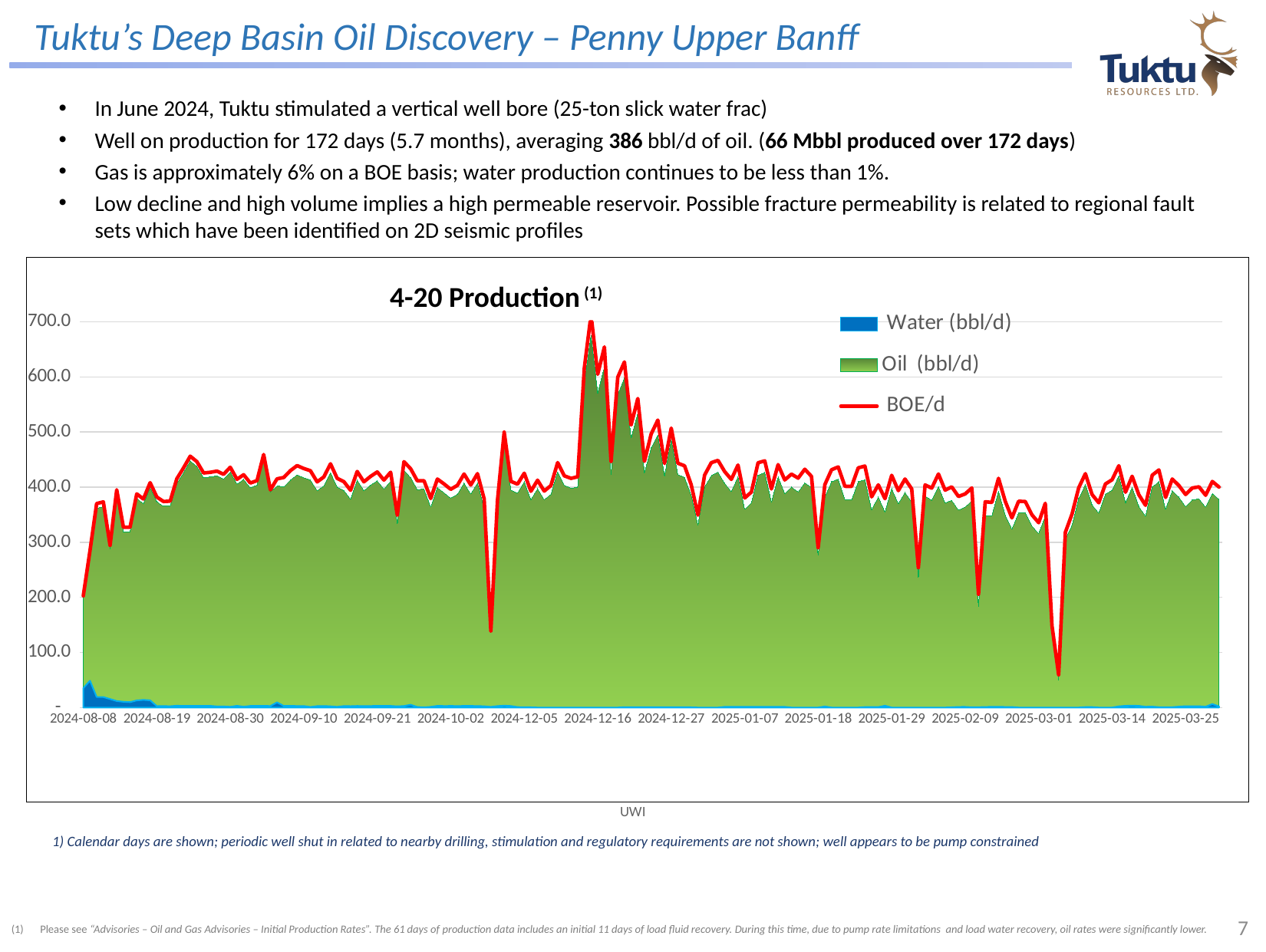
Is the BOE/d value at the start of the chart (2024-08-08) greater or less than 300? less What are the three series listed in the legend of the 4-20 Production chart? Water (bbl/d), Oil (bbl/d), BOE/d How many series does the legend of the 4-20 Production chart list? 3 What is the highest value shown on the y axis of the 4-20 Production chart? 700.0 Is the Water (bbl/d) value at any point in the chart greater or less than 100? less Which series in the 4-20 Production chart has the highest values throughout the period? BOE/d Is the lowest BOE/d dip near 2025-03-01 greater or less than 100? less How many date labels are shown on the x axis of the 4-20 Production chart? 16 What kind of chart is the 4-20 Production chart? Area chart with a line series What is the title of the chart on the slide? 4-20 Production Which series in the 4-20 Production chart has the lowest values throughout the period? Water (bbl/d)